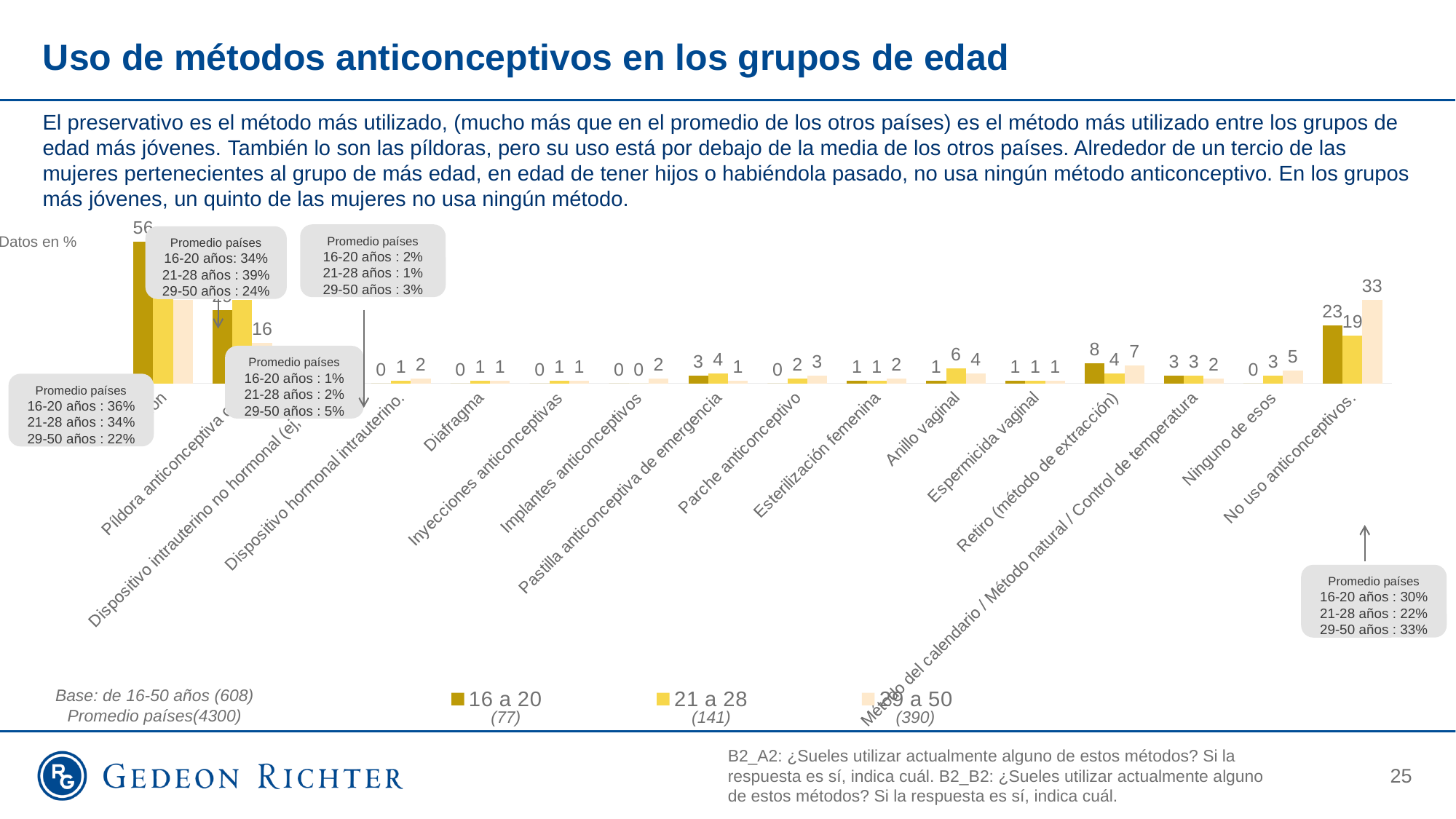
What kind of chart is shown on the slide? bar chart What base size is shown under the '21 a 28' legend entry? (141) How many series does the legend list? 3 For 'Retiro (método de extracción)', which series has the larger value: 16 a 20 or 29 a 50? 16 a 20 What is the value for 'Anillo vaginal' in the 21 a 28 series? 6 What is the difference between the 21 a 28 and 29 a 50 values for 'Anillo vaginal'? 2 What is the value for 'Retiro (método de extracción)' in the 16 a 20 series? 8 What is the value for 'Ninguno de esos' in the 29 a 50 series? 5 For 'No uso anticonceptivos.', which age group series has the highest value? 29 a 50 What is the value for 'No uso anticonceptivos.' in the 29 a 50 series? 33 What is the difference between the 29 a 50 and 16 a 20 values for 'No uso anticonceptivos.'? 10 What is the value for 'Pastilla anticonceptiva de emergencia' in the 21 a 28 series? 4